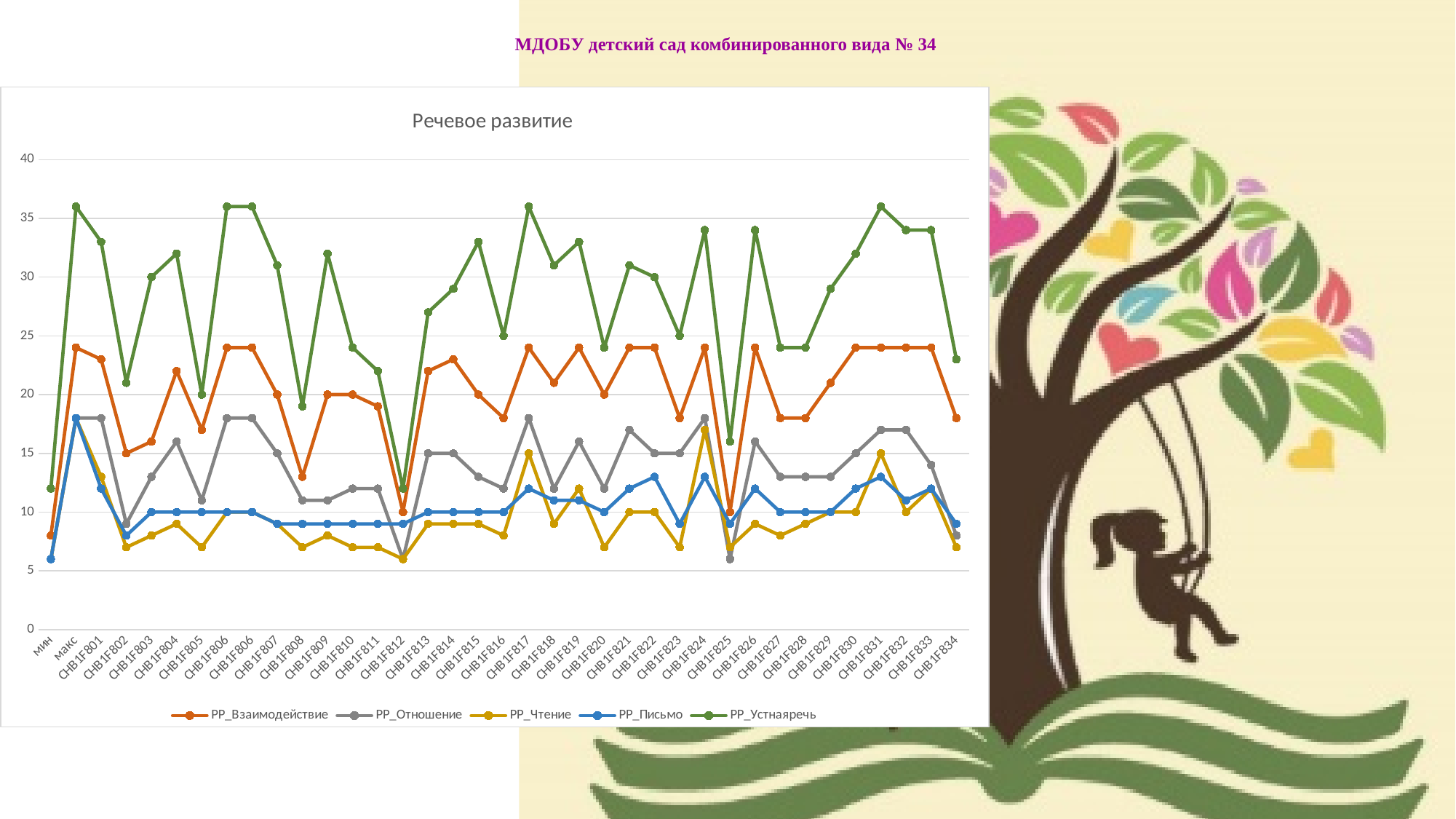
Is the value of РР_Устнаяречь for CHB1F806 greater or less than 30? greater How many series does the legend list? 5 Is the value of РР_Устнаяречь for CHB1F825 greater or less than 20? less What is the title of the chart? Речевое развитие For CHB1F825, which is larger: РР_Устнаяречь or РР_Взаимодействие? РР_Устнаяречь For CHB1F801, which is larger: РР_Взаимодействие or РР_Письмо? РР_Взаимодействие Which series has the highest values across the chart? РР_Устнаяречь Which colour is used for the РР_Устнаяречь series in the legend? green What kind of chart is shown on the slide? line chart How many categories are shown along the x axis? 37 Is the value of РР_Чтение for CHB1F812 greater or less than 10? less